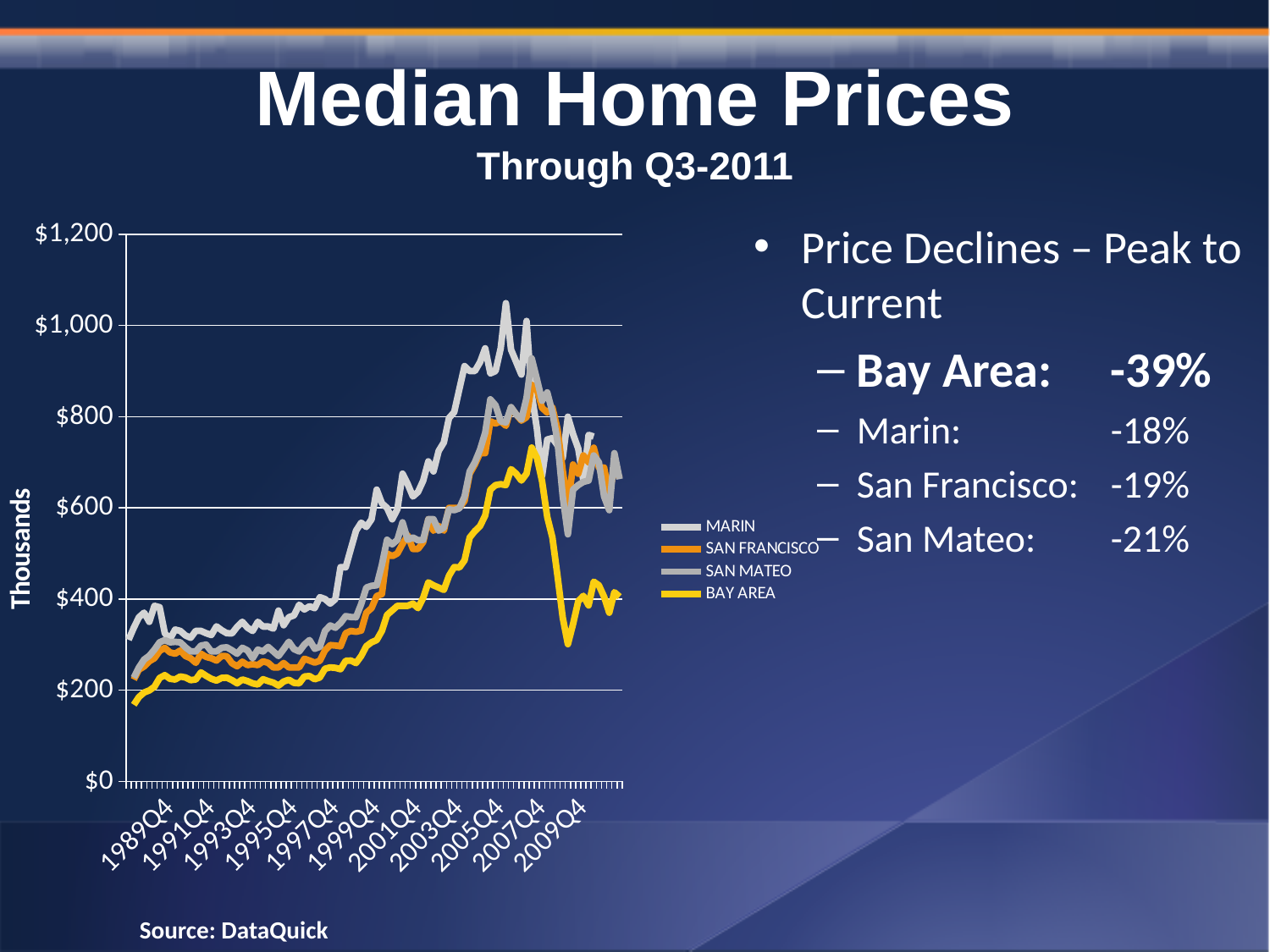
What is the label on the chart's vertical axis? Thousands What kind of chart is shown on the slide? line chart Is the MARIN value at 1989Q4 greater or less than $400? less Which series stays lowest across the chart? BAY AREA Do the series generally rise or fall from 1989Q4 to 2005Q4? rise Which series are listed in the chart's legend? MARIN, SAN FRANCISCO, SAN MATEO, BAY AREA Is the peak value of the MARIN series greater or less than $1,000? greater Is the peak value of the BAY AREA series greater or less than $800? less How many series does the chart's legend list? 4 Which series reaches the highest value on the chart? MARIN At 2005Q4, which series has the larger value, MARIN or BAY AREA? MARIN